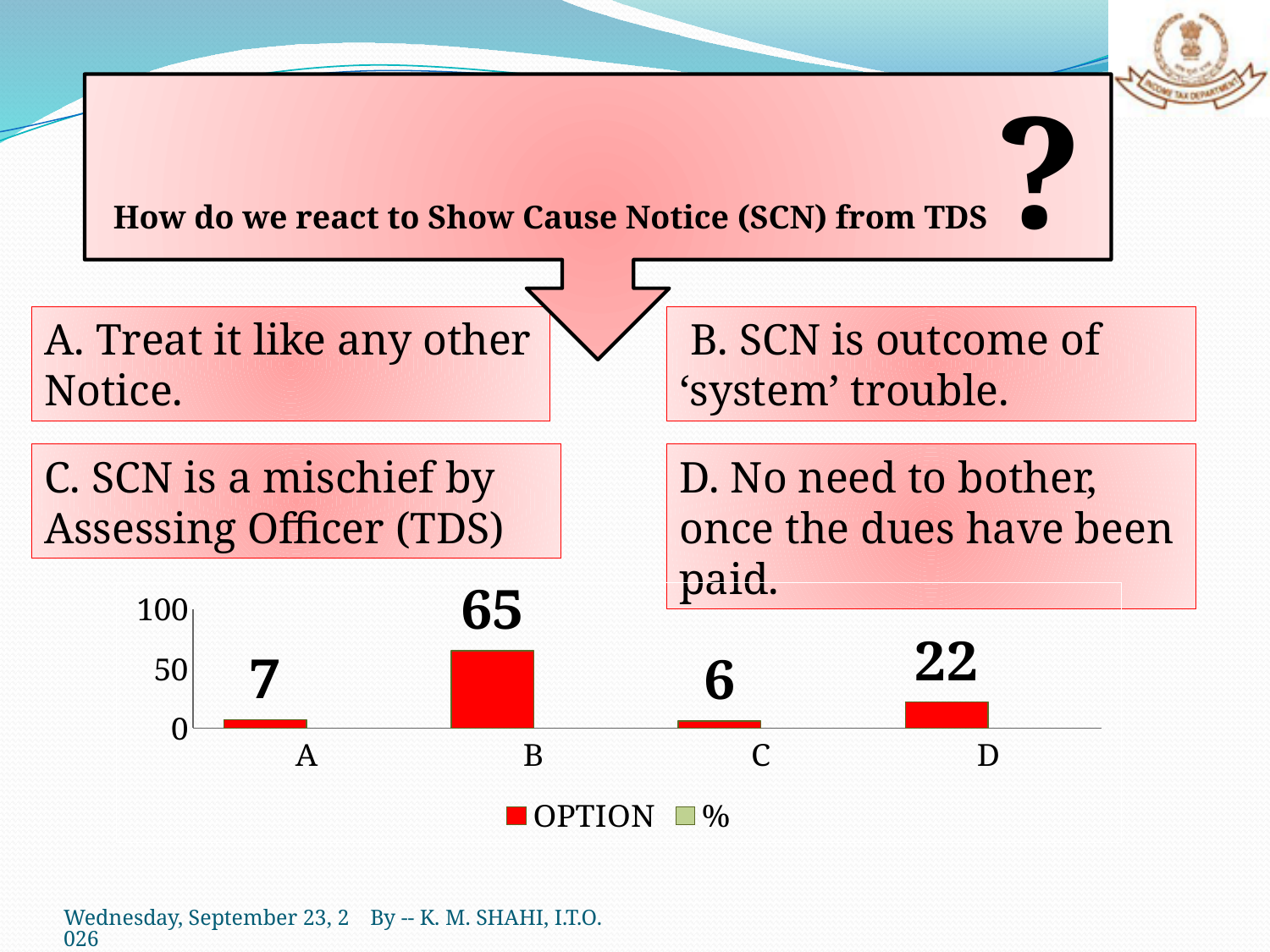
What value is shown for category D in the bar chart? 22 How many categories are shown on the x axis of the bar chart? 4 How many series does the chart legend list? 2 What value is shown for category A in the bar chart? 7 What kind of chart is shown on the slide? bar chart Which has the larger value in the bar chart, A or C? A What are the two entries in the chart legend? OPTION and % Which category has the highest value in the bar chart? B Is the value for B greater or less than 50? greater What value is shown for category B in the bar chart? 65 What is the difference between the values for B and D in the bar chart? 43 Which category has the lowest value in the bar chart? C